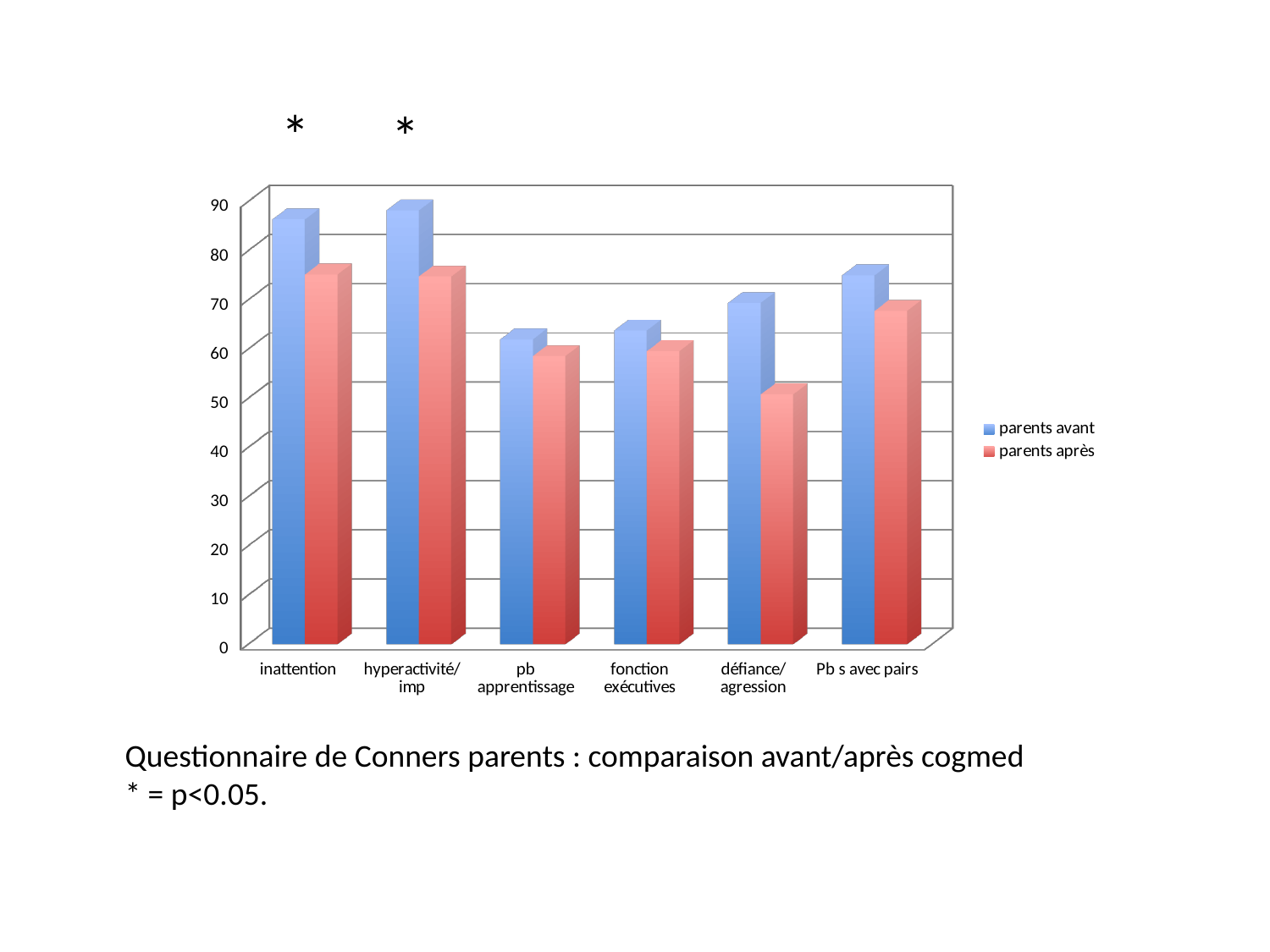
Is the value for hyperactivité/imp in the parents après series greater or less than 70? greater How many categories are shown on the x axis of the chart? 6 Is the value for pb apprentissage in the parents avant series greater or less than 50? greater Is the value for défiance/agression in the parents après series greater or less than 60? less What are the two series named in the legend? parents avant, parents après Which category has the highest value in the parents avant series? hyperactivité/imp What kind of chart is shown on the slide? bar chart For inattention, which is larger: the parents avant value or the parents après value? parents avant Which categories are marked with an asterisk above the chart? inattention and hyperactivité/imp How many series does the legend list? 2 Which category has the lowest value in the parents après series? défiance/agression